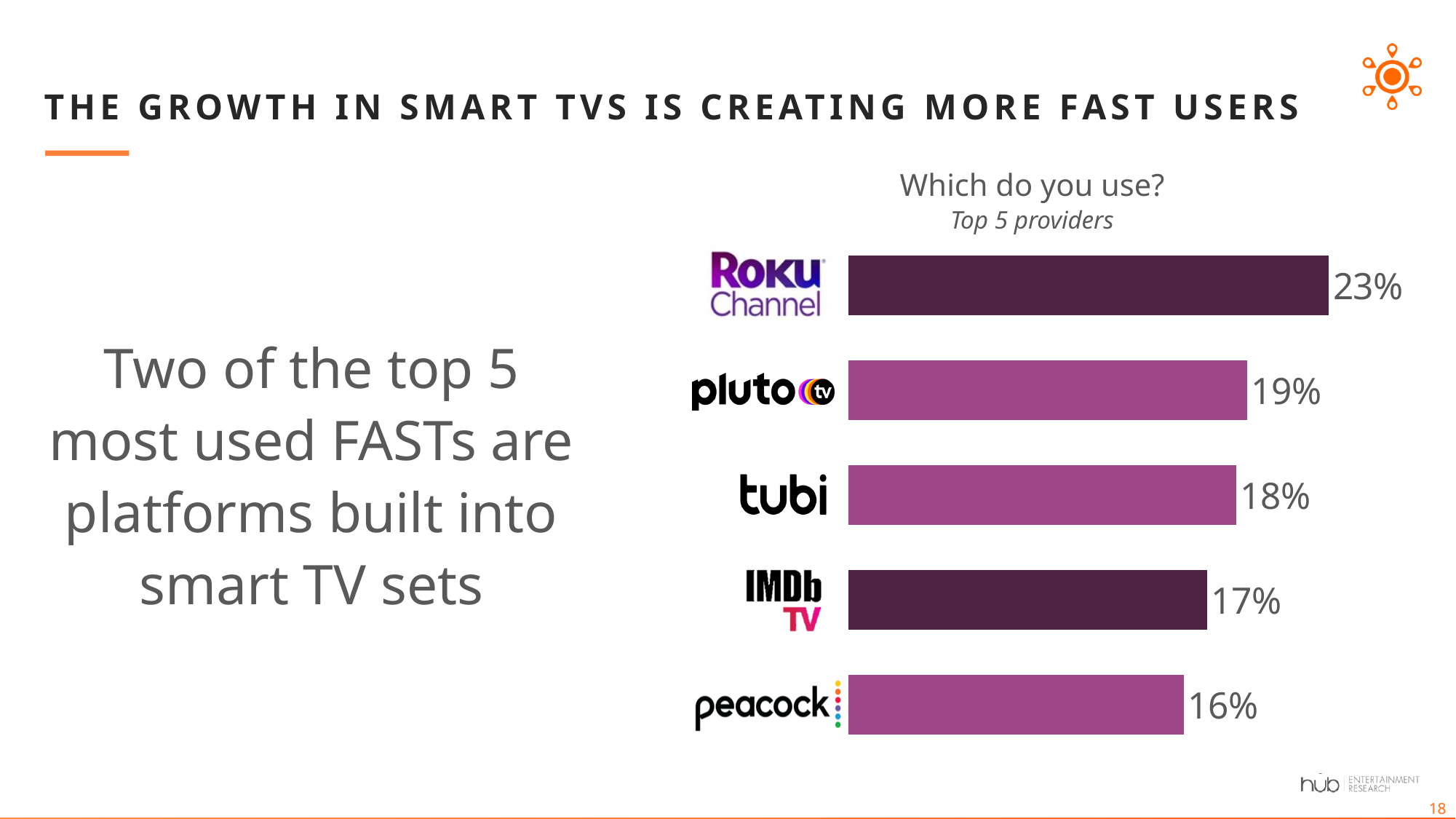
What is the difference in percentage points between Pluto TV and IMDb TV? 2 What percentage of respondents use Peacock? 16% What percentage of respondents use Pluto TV? 19% What percentage of respondents use Tubi? 18% Which provider has the highest share of users in the chart? Roku Channel What kind of chart is shown on the slide? Bar chart What percentage of respondents use Roku Channel? 23% How many providers are shown in the chart? 5 What is the title of the chart? Which do you use? Which has a higher share of users, Tubi or IMDb TV? Tubi Which provider has the lowest share of users in the chart? Peacock What is the difference in percentage points between Roku Channel and Peacock? 7